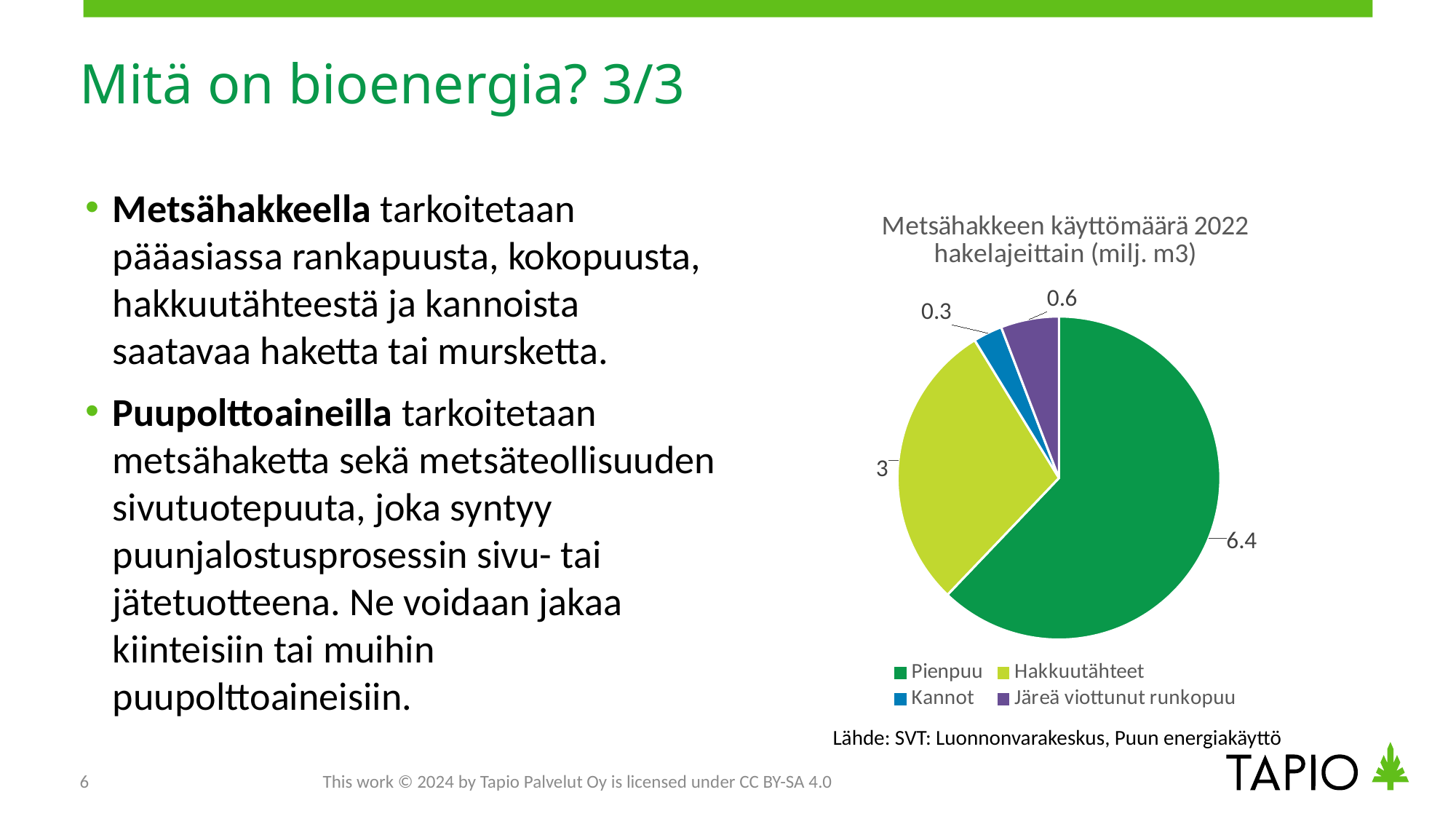
What is the value for Järeä viottunut runkopuu in the pie chart? 0.6 Which category has the largest slice in the pie chart? Pienpuu What is the total of all the values shown in the pie chart? 10.3 How many categories does the pie chart show? 4 Which is larger, the value for Järeä viottunut runkopuu or the value for Kannot? Järeä viottunut runkopuu What is the value for Kannot in the pie chart? 0.3 What is the title of the chart? Metsähakkeen käyttömäärä 2022 hakelajeittain (milj. m3) What is the value for Pienpuu in the pie chart? 6.4 What is the value for Hakkuutähteet in the pie chart? 3 What kind of chart is shown on the slide? Pie chart Which category has the smallest slice in the pie chart? Kannot What is the difference between the values for Pienpuu and Hakkuutähteet? 3.4